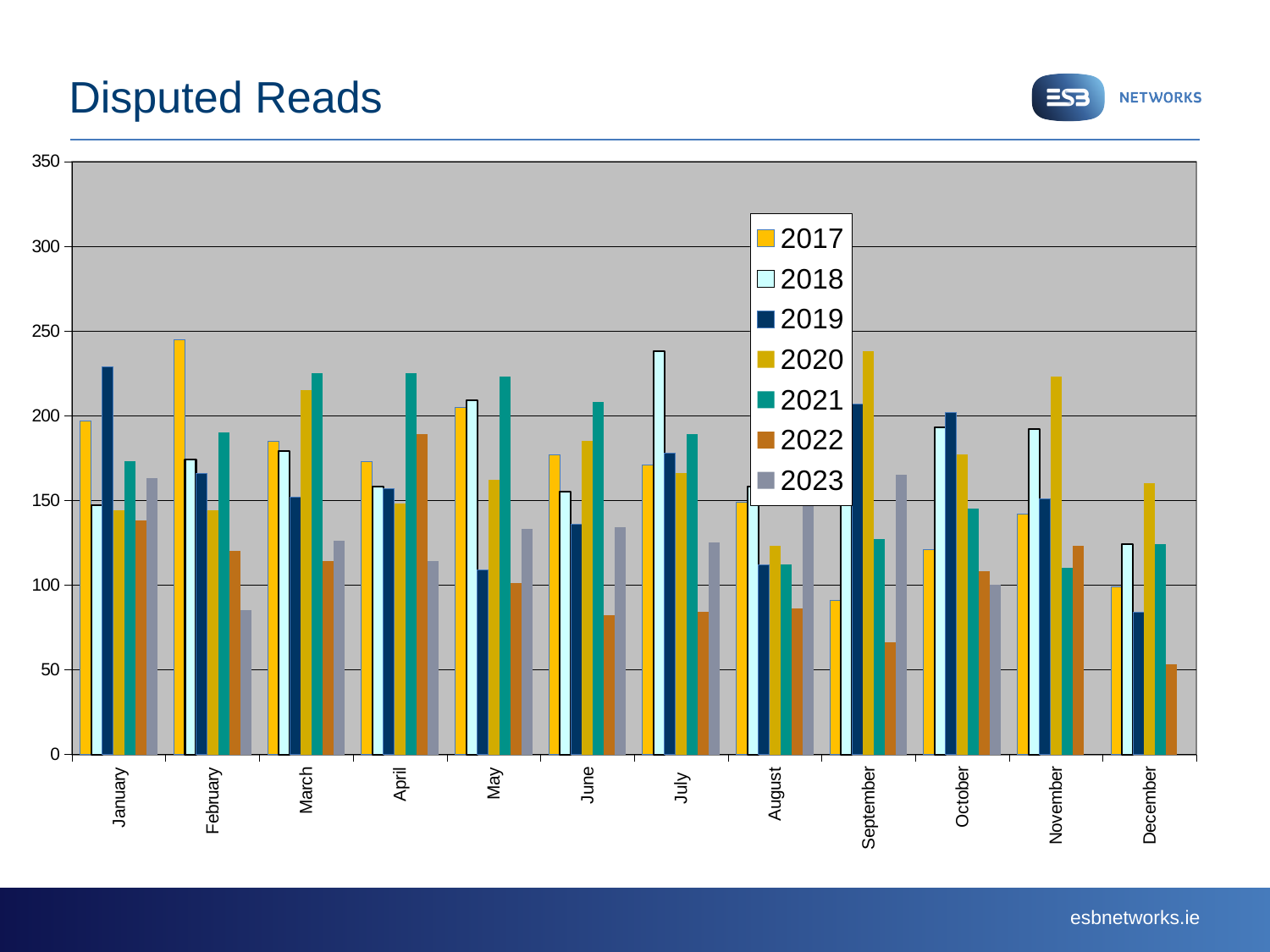
Is the value for 2017 in February greater or less than 200? greater What is the title of the chart? Disputed Reads Is the value for 2018 in July greater or less than 200? greater Is the value for 2022 in September greater or less than 100? less How many months are shown along the x axis? 12 In May, which year has the highest value? 2021 In February, which year has the highest value? 2017 In January, which is larger: the value for 2017 or the value for 2019? 2019 In September, which year has the lowest value? 2022 How many series does the legend list? 7 What kind of chart is shown on the slide? bar chart